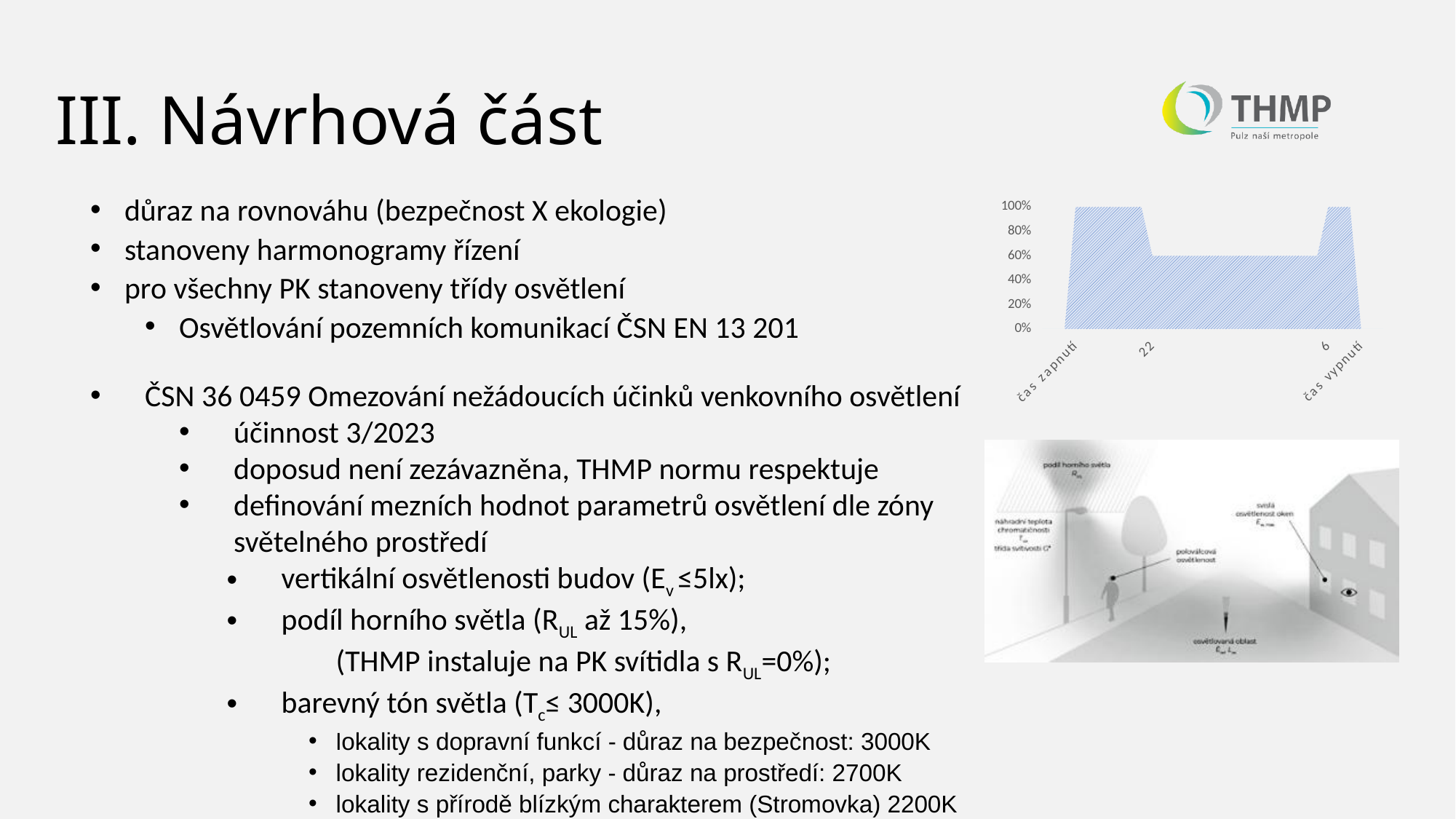
In the chart at the top right, is the value just after 6 greater or less than 80%? greater In the chart at the top right, is the value between 22 and 6 greater or less than 40%? greater In the chart at the top right, what is the last label on the x axis? čas vypnutí In the chart at the top right, is the value between 22 and 6 greater or less than 80%? less In the chart at the top right, which is larger: the value just before 22 or the value between 22 and 6? the value just before 22 In the chart at the top right, how many labels are shown along the x axis? 4 What kind of chart is shown at the top right of the slide? area chart In the chart at the top right, what is the highest tick label on the y axis? 100% In the chart at the top right, how many tick labels are shown on the y axis? 6 In the chart at the top right, does the value fall or rise when moving from before 22 to between 22 and 6? fall In the chart at the top right, what is the first label on the x axis? čas zapnutí